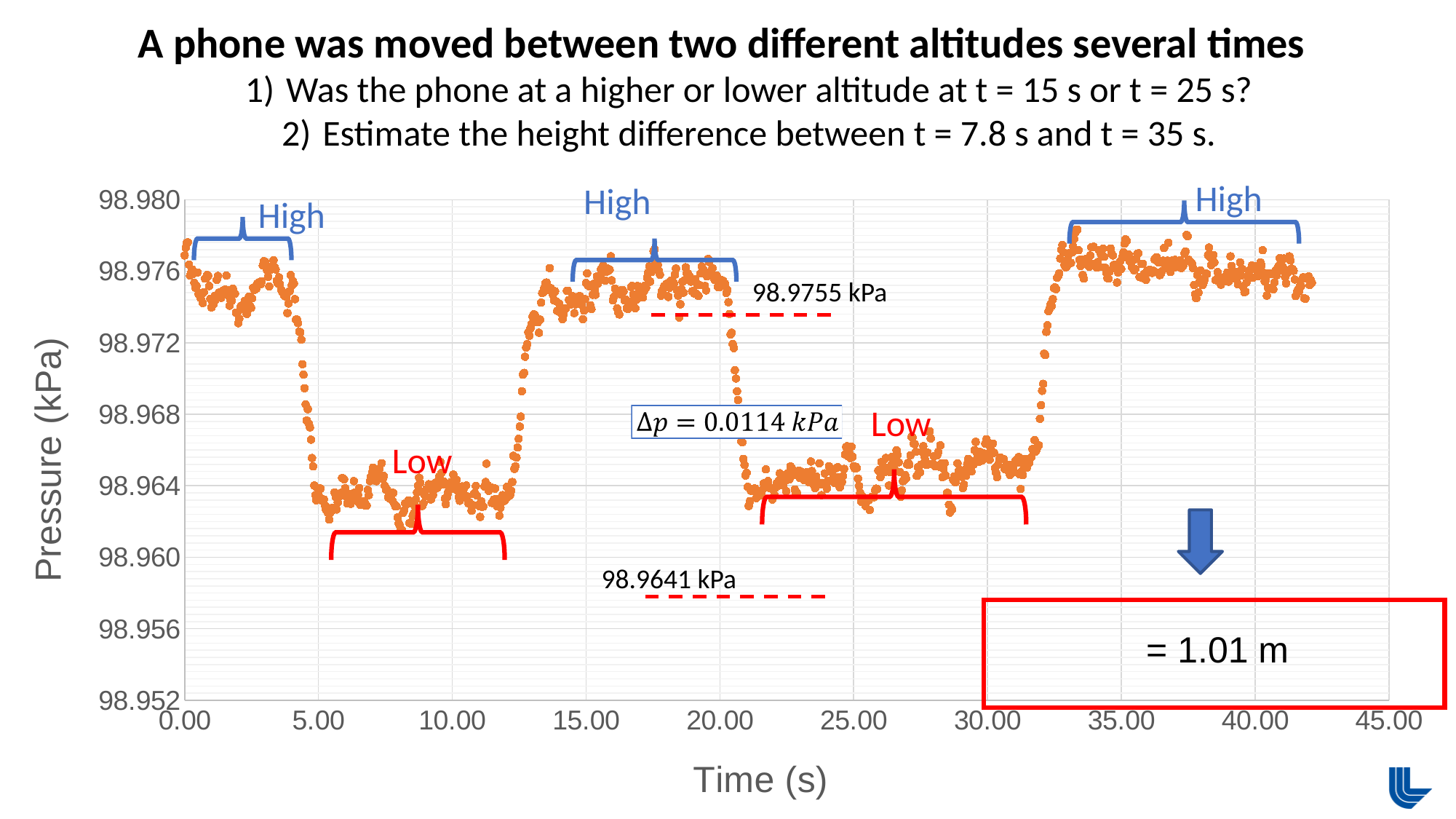
Is the pressure at t = 15 s greater or less than 98.972 kPa? greater What pressure value is annotated for the high-altitude plateau around t = 15 to 20 s? 98.9755 kPa Does the pressure rise or fall between t = 4 s and t = 6 s? fall What pressure value is annotated for the low-altitude plateau around t = 22 to 31 s? 98.9641 kPa What is the label of the x axis? Time (s) Is the pressure at t = 25 s greater or less than 98.968 kPa? less How many segments of the data are labelled "High"? 3 What is the label of the y axis? Pressure (kPa) What kind of chart is shown on the slide? scatter chart Which time has the higher pressure reading, t = 15 s or t = 25 s? t = 15 s Is the pressure at t = 7.8 s greater or less than 98.968 kPa? less What is the pressure difference Δp between the annotated high and low plateau values? 0.0114 kPa